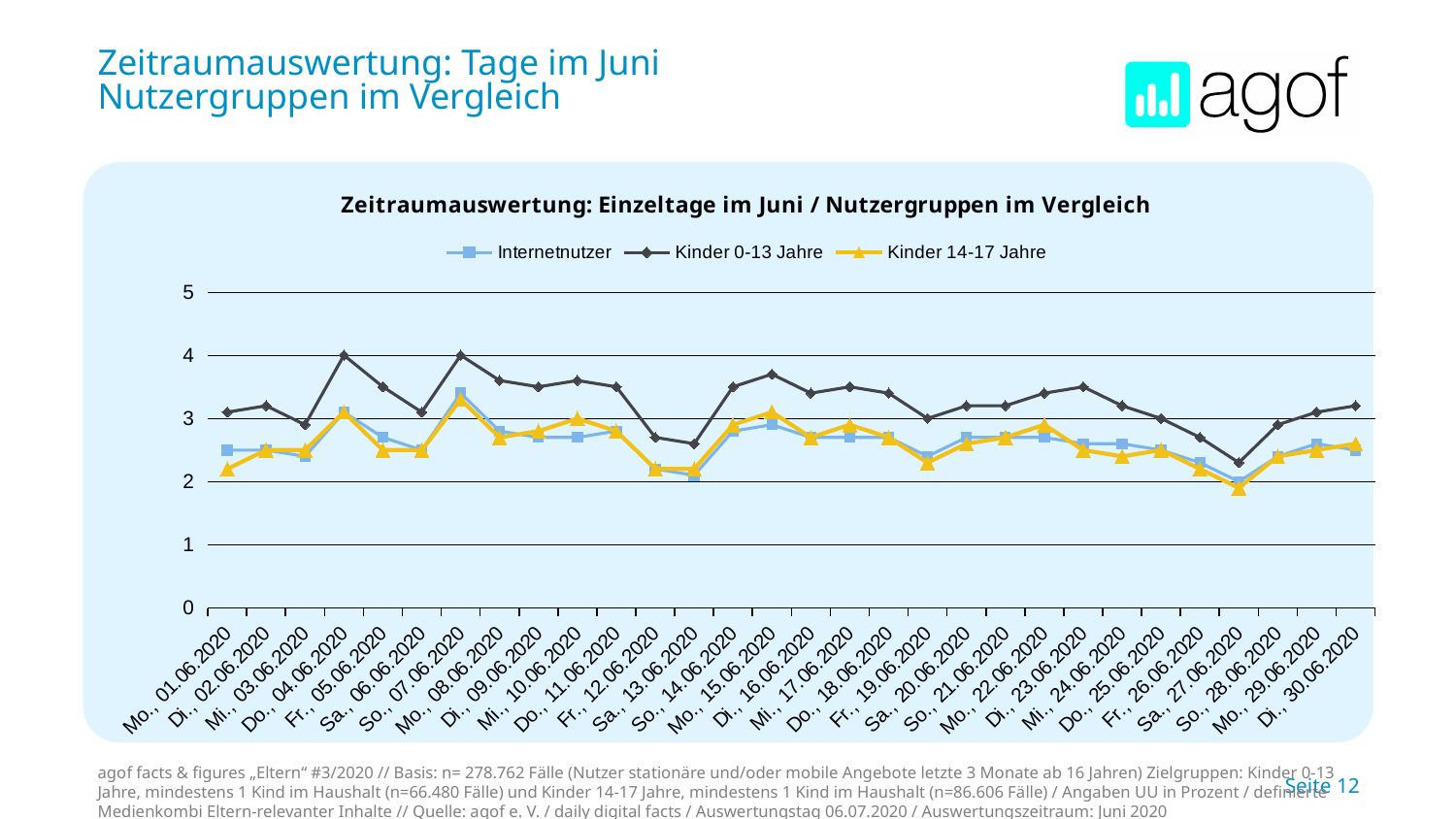
How many series does the legend list? 3 Is the value for Kinder 14-17 Jahre on Mo., 01.06.2020 greater or less than 3? less Is the value for Kinder 0-13 Jahre on Do., 04.06.2020 greater or less than 3? greater What is the title of the chart? Zeitraumauswertung: Einzeltage im Juni / Nutzergruppen im Vergleich How many dates are plotted along the x axis? 30 Is the value for Internetnutzer on Sa., 13.06.2020 greater or less than 3? less Which series has the highest value on Di., 16.06.2020? Kinder 0-13 Jahre On which date does Kinder 14-17 Jahre reach its lowest value? Sa., 27.06.2020 On Do., 04.06.2020, which is larger: Kinder 0-13 Jahre or Kinder 14-17 Jahre? Kinder 0-13 Jahre Does the Kinder 0-13 Jahre line rise or fall from Mi., 24.06.2020 to Sa., 27.06.2020? fall What kind of chart is shown on the slide? line chart